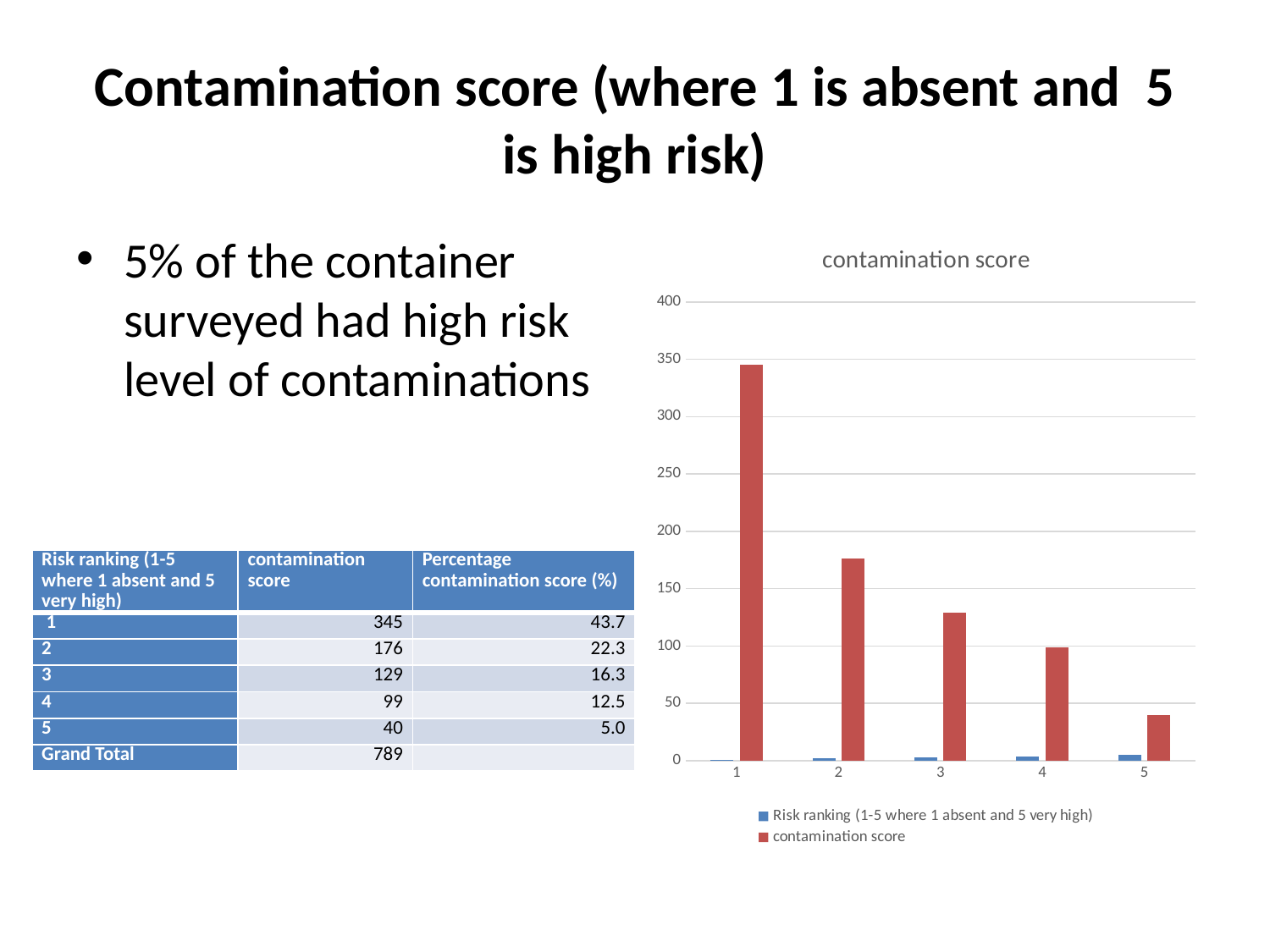
Which risk ranking has the highest contamination score in the chart? 1 What kind of chart is shown on the slide? bar chart What is the contamination score for risk ranking 1, as printed in the table on the slide? 345 Which risk ranking has the lowest contamination score in the chart? 5 Do the contamination score bars rise or fall as the risk ranking increases from 1 to 5? fall What is the title of the chart? contamination score Is the contamination score for risk ranking 1 greater or less than 300? greater Is the contamination score for risk ranking 3 greater or less than 100? greater How many risk ranking categories are plotted along the x axis of the chart? 5 Is the contamination score for risk ranking 5 greater or less than 50? less Which has a larger contamination score, risk ranking 2 or risk ranking 4? risk ranking 2 How many series does the chart legend list? 2